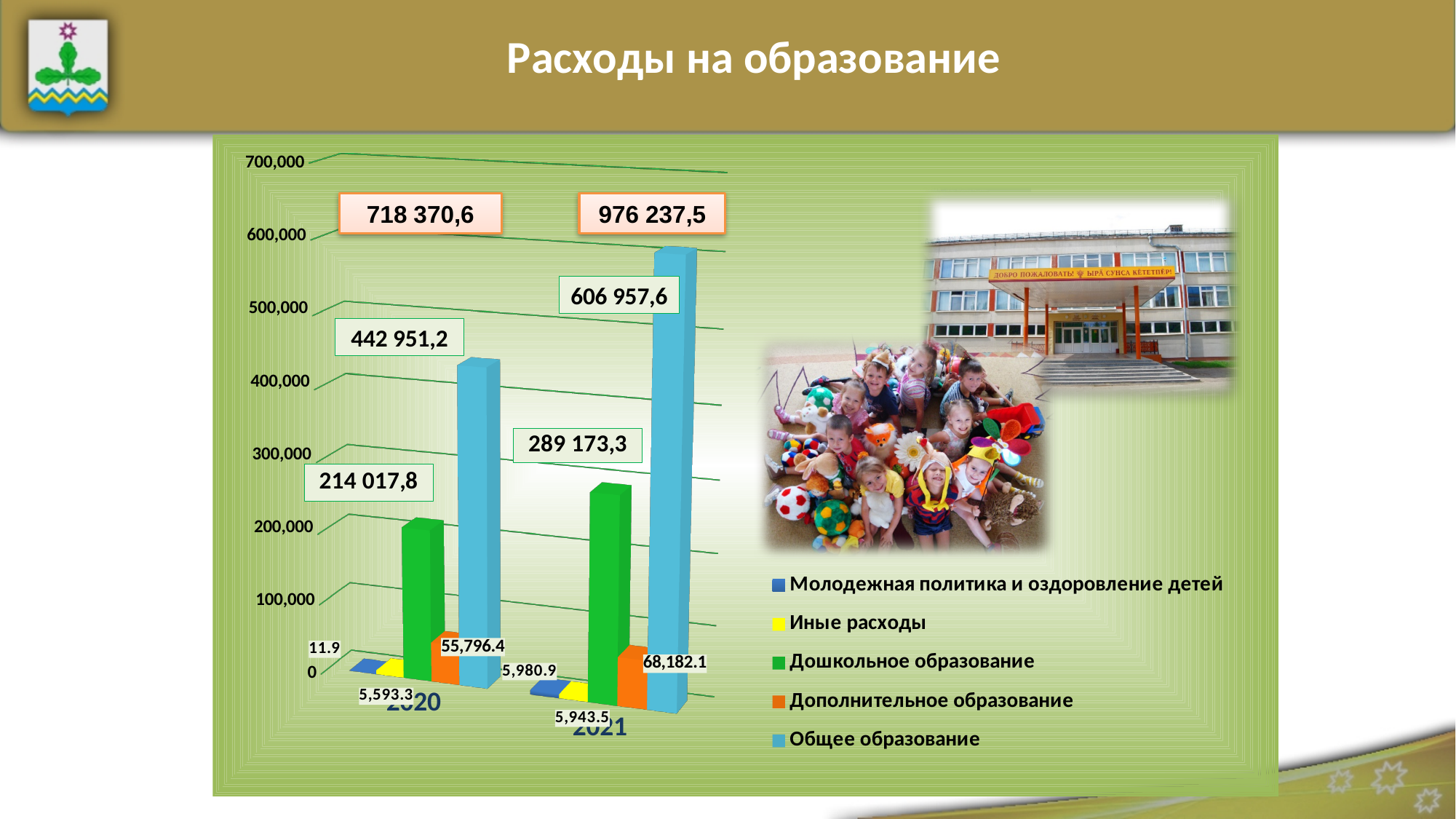
Does the value for Общее образование rise or fall from 2020 to 2021? rise How many year categories are shown on the x axis? 2 How many series does the legend list? 5 Which series has the highest value in 2021? Общее образование Which series has the lowest value in 2020? Молодежная политика и оздоровление детей What is the value for Общее образование in 2021? 606 957,6 What is the value for Дошкольное образование in 2020? 214 017,8 What total is shown in the box above the 2021 bars? 976 237,5 What is the value for Молодежная политика и оздоровление детей in 2020? 11.9 What is the value for Дополнительное образование in 2021? 68,182.1 What kind of chart is shown on the slide? bar chart Which is larger: Дошкольное образование in 2020 or in 2021? 2021